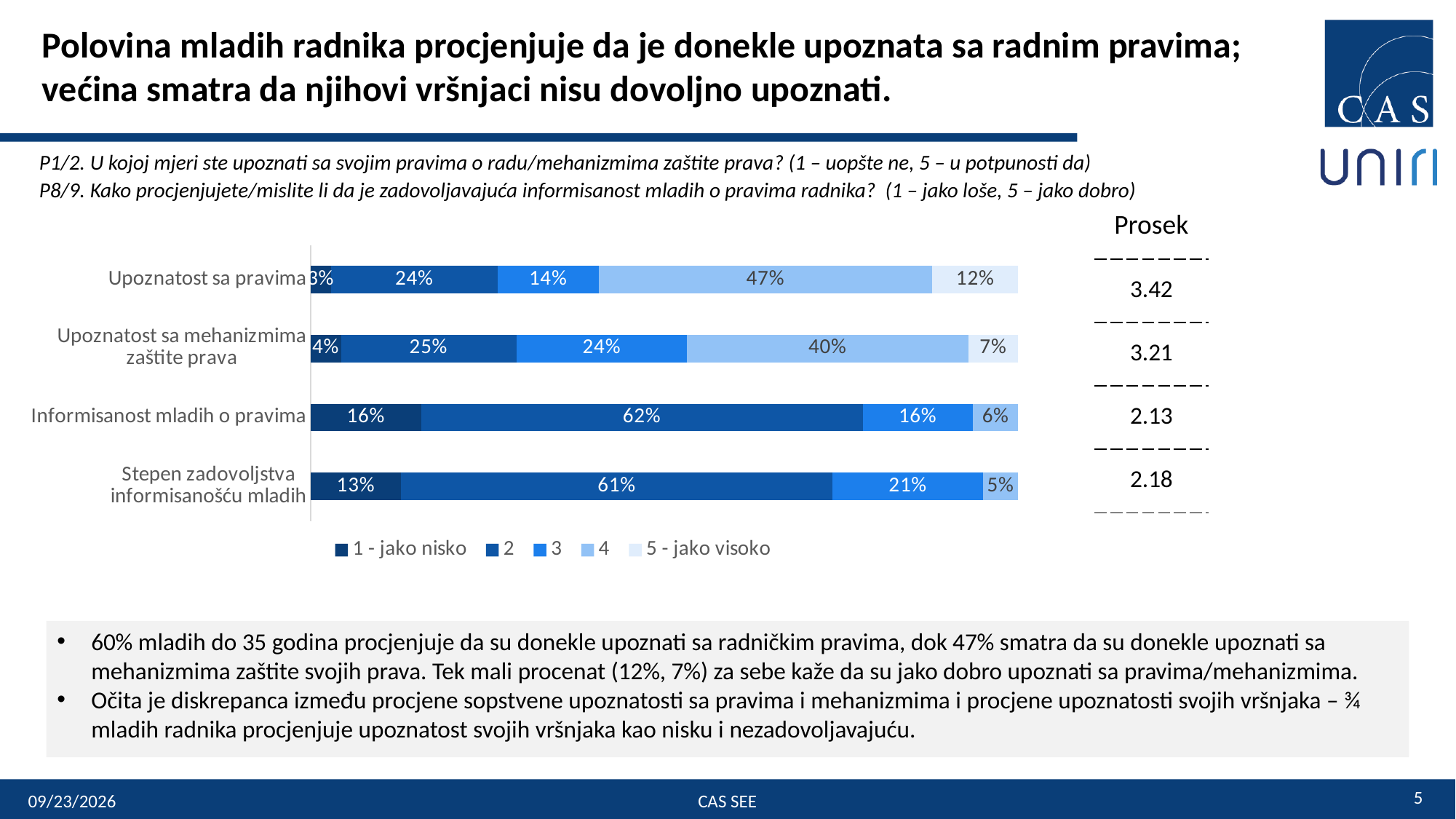
What is the value of the '2' segment for 'Informisanost mladih o pravima'? 62% What is the first entry in the chart legend? 1 - jako nisko What is the value of the '1 - jako nisko' segment for 'Stepen zadovoljstva informisanošću mladih'? 13% What kind of chart is shown on the slide? Stacked bar chart How many series does the legend list? 5 How many categories does the chart show? 4 What is the value of the '4' segment for 'Upoznatost sa pravima'? 47% Which is larger: the '3' segment for 'Stepen zadovoljstva informisanošću mladih' or the '3' segment for 'Informisanost mladih o pravima'? Stepen zadovoljstva informisanošću mladih Which category has the largest '2' segment? Informisanost mladih o pravima Which category has the smallest '1 - jako nisko' segment? Upoznatost sa pravima What is the difference between the '4' segment for 'Upoznatost sa pravima' and the '4' segment for 'Upoznatost sa mehanizmima zaštite prava'? 7% What is the value of the '5 - jako visoko' segment for 'Upoznatost sa mehanizmima zaštite prava'? 7%